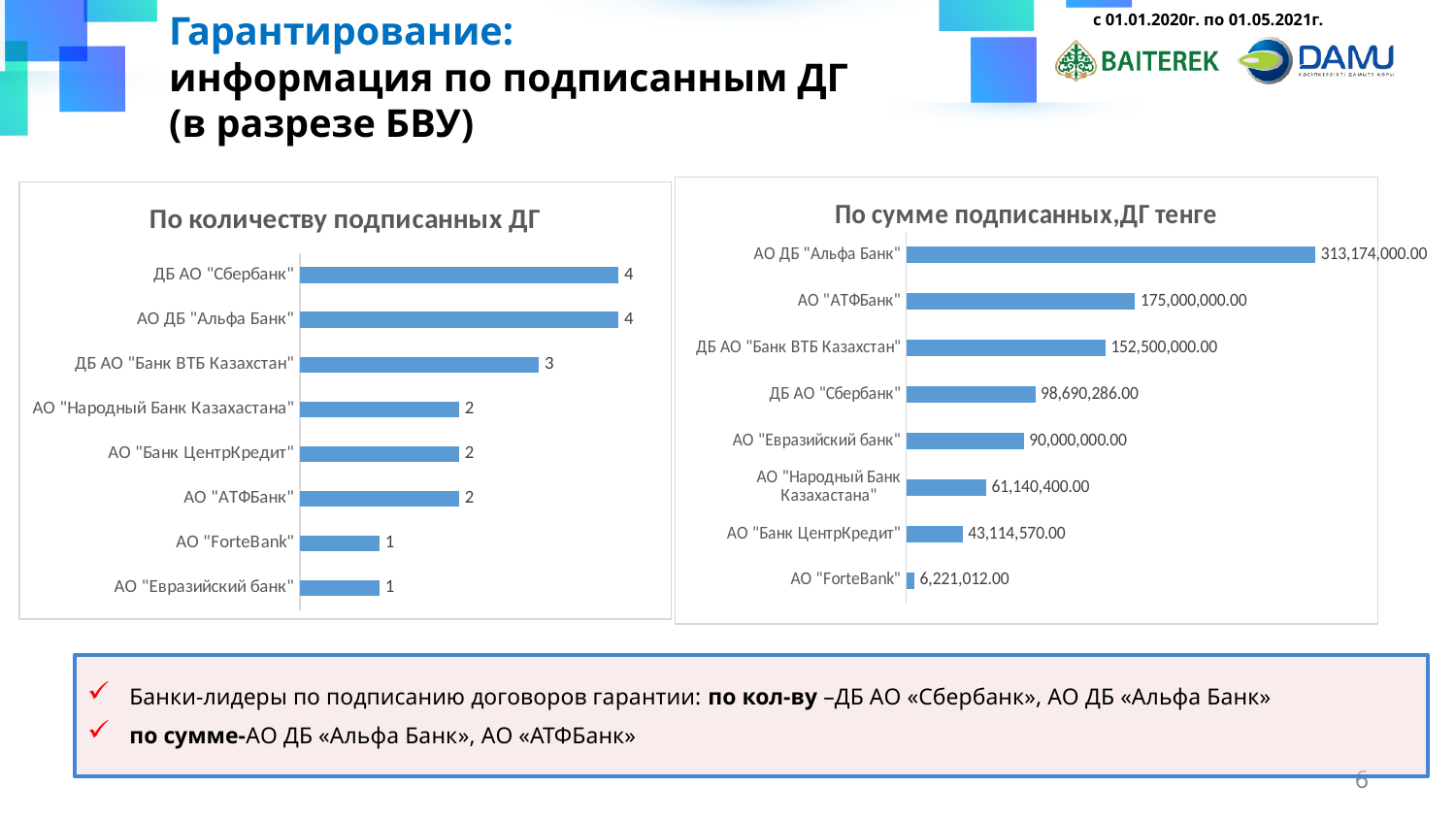
In the chart "По количеству подписанных ДГ", how many banks are listed? 8 In the chart "По сумме подписанных,ДГ тенге", which is larger: the value for ДБ АО "Сбербанк" or АО "Евразийский банк"? ДБ АО "Сбербанк" In the chart "По количеству подписанных ДГ", what is the value for ДБ АО "Банк ВТБ Казахстан"? 3 In the chart "По сумме подписанных,ДГ тенге", what is the value for АО "Банк ЦентрКредит"? 43,114,570.00 What type of chart is "По сумме подписанных,ДГ тенге"? Bar chart In the chart "По сумме подписанных,ДГ тенге", which bank has the highest value? АО ДБ "Альфа Банк" In the chart "По сумме подписанных,ДГ тенге", which bank has the lowest value? АО "ForteBank" In the chart "По сумме подписанных,ДГ тенге", what is the difference between the values for АО ДБ "Альфа Банк" and АО "АТФБанк"? 138,174,000.00 In the chart "По количеству подписанных ДГ", what is the difference between the values for ДБ АО "Сбербанк" and АО "Банк ЦентрКредит"? 2 In the chart "По сумме подписанных,ДГ тенге", what is the value for АО "АТФБанк"? 175,000,000.00 What is the title of the chart on the left side of the slide? По количеству подписанных ДГ In the chart "По количеству подписанных ДГ", what is the value for АО "ForteBank"? 1